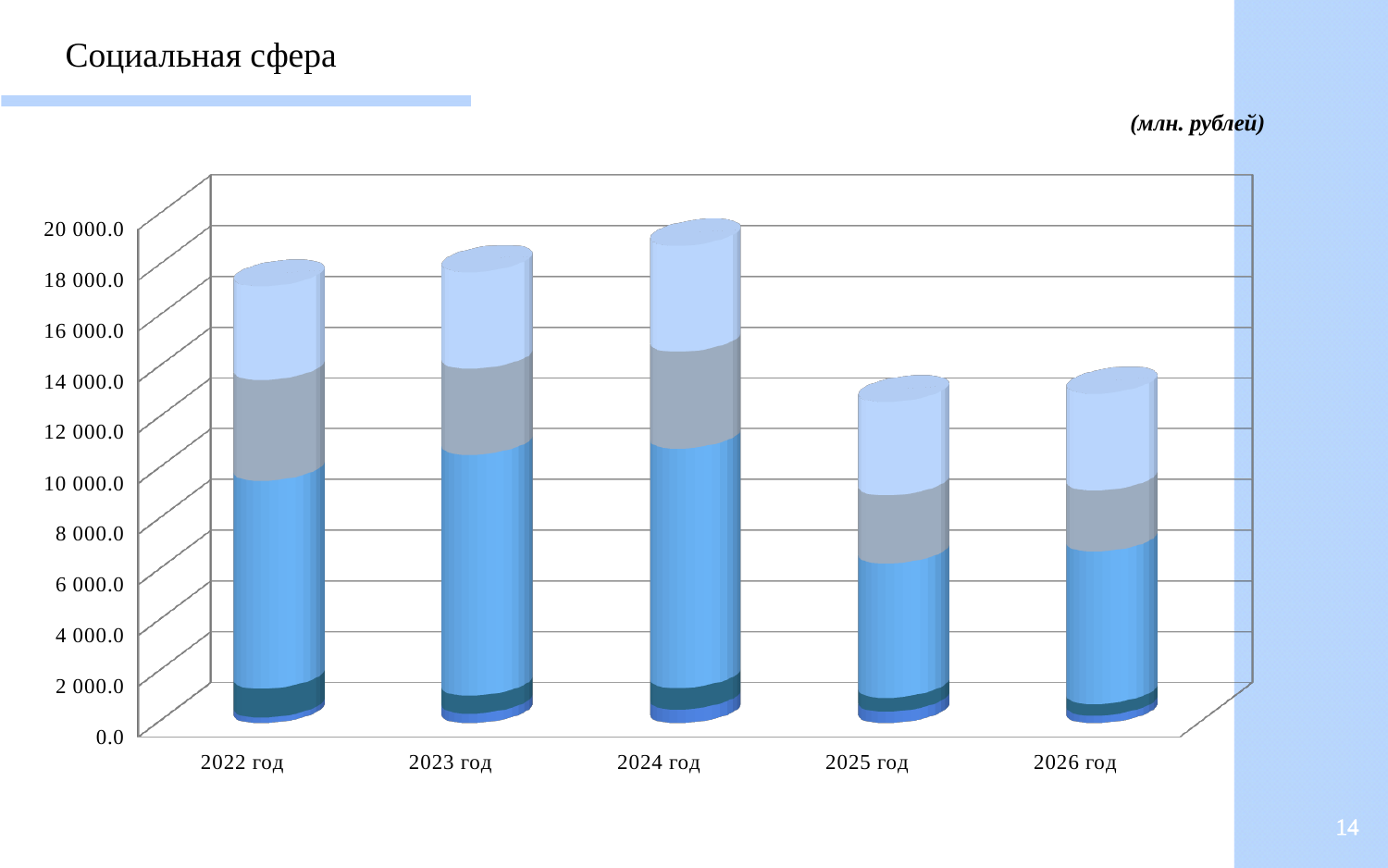
Which year has the tallest stacked bar in the chart? 2024 год Is the total for 2025 год greater or less than 16 000.0? less What is the title of the slide containing the chart? Социальная сфера What kind of chart is shown on the slide? stacked bar chart Is the total for 2026 год greater or less than 10 000.0? greater Which bar is taller, 2024 год or 2026 год? 2024 год In what units are the chart values given, according to the slide? млн. рублей How do the bar totals change from 2022 год to 2024 год? they rise Is the total for 2024 год greater or less than 16 000.0? greater How many years (categories) are shown on the x axis of the chart? 5 Which bar is taller, 2023 год or 2025 год? 2023 год